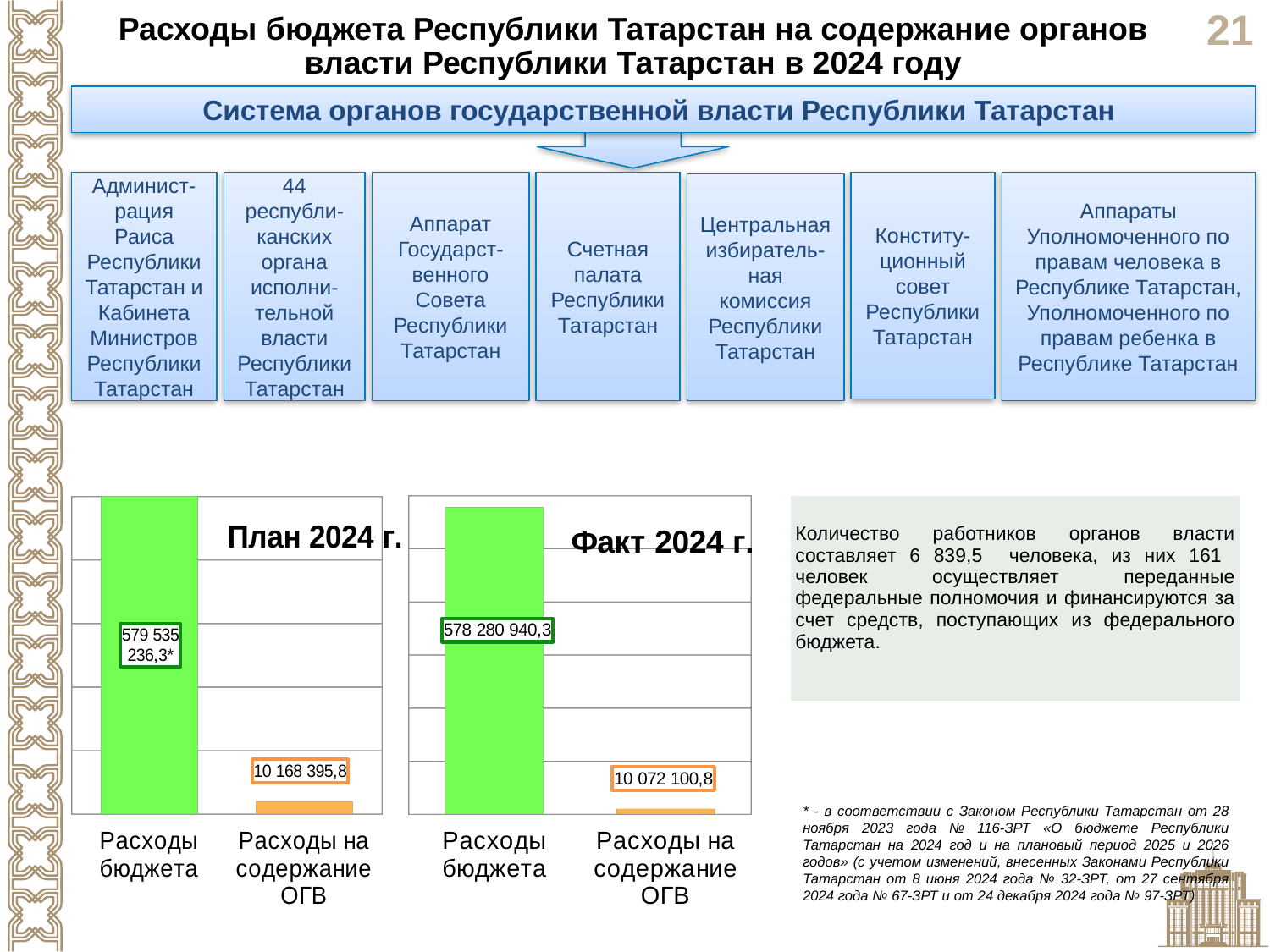
On the "План 2024 г." chart, what is the difference between "Расходы бюджета" and "Расходы на содержание ОГВ"? 569 366 840,5 On the "План 2024 г." chart, what is the value for "Расходы бюджета"? 579 535 236,3* On the "Факт 2024 г." chart, what is the value for "Расходы бюджета"? 578 280 940,3 What is the difference between "Расходы бюджета" on the "План 2024 г." chart and on the "Факт 2024 г." chart? 1 254 296,0 On the "Факт 2024 г." chart, what is the difference between "Расходы бюджета" and "Расходы на содержание ОГВ"? 568 208 839,5 On the "План 2024 г." chart, which category has the highest value? Расходы бюджета On the "Факт 2024 г." chart, which category has the lowest value? Расходы на содержание ОГВ How many categories are shown on the "Факт 2024 г." chart? 2 Which is larger: "Расходы на содержание ОГВ" on the "План 2024 г." chart or on the "Факт 2024 г." chart? План 2024 г. What type of chart is the "План 2024 г." chart? Bar chart On the "План 2024 г." chart, what is the value for "Расходы на содержание ОГВ"? 10 168 395,8 On the "Факт 2024 г." chart, what is the value for "Расходы на содержание ОГВ"? 10 072 100,8